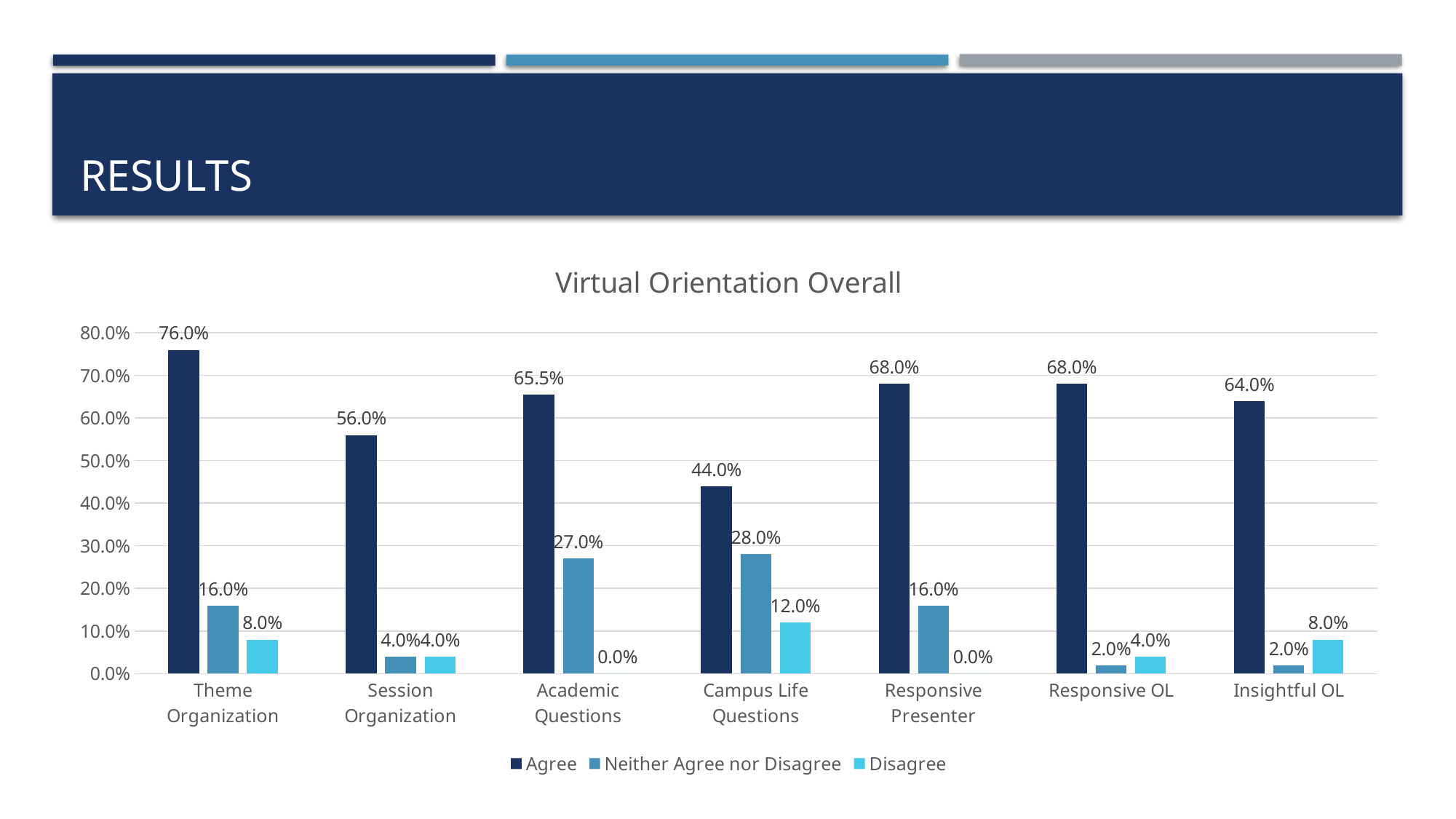
What is the difference between the Agree values for Theme Organization and Session Organization? 20.0% How many series does the legend list? 3 What is the Neither Agree nor Disagree value for Campus Life Questions? 28.0% What is the Disagree value for Academic Questions? 0.0% What is the Disagree value for Insightful OL? 8.0% What kind of chart is shown? Bar chart Which category has the highest Agree value? Theme Organization What is the Agree value for Theme Organization? 76.0% What is the title of the chart? Virtual Orientation Overall Which category has the lowest Agree value? Campus Life Questions Which is larger, the Neither Agree nor Disagree value for Academic Questions or for Campus Life Questions? Campus Life Questions How many categories are shown on the x axis? 7